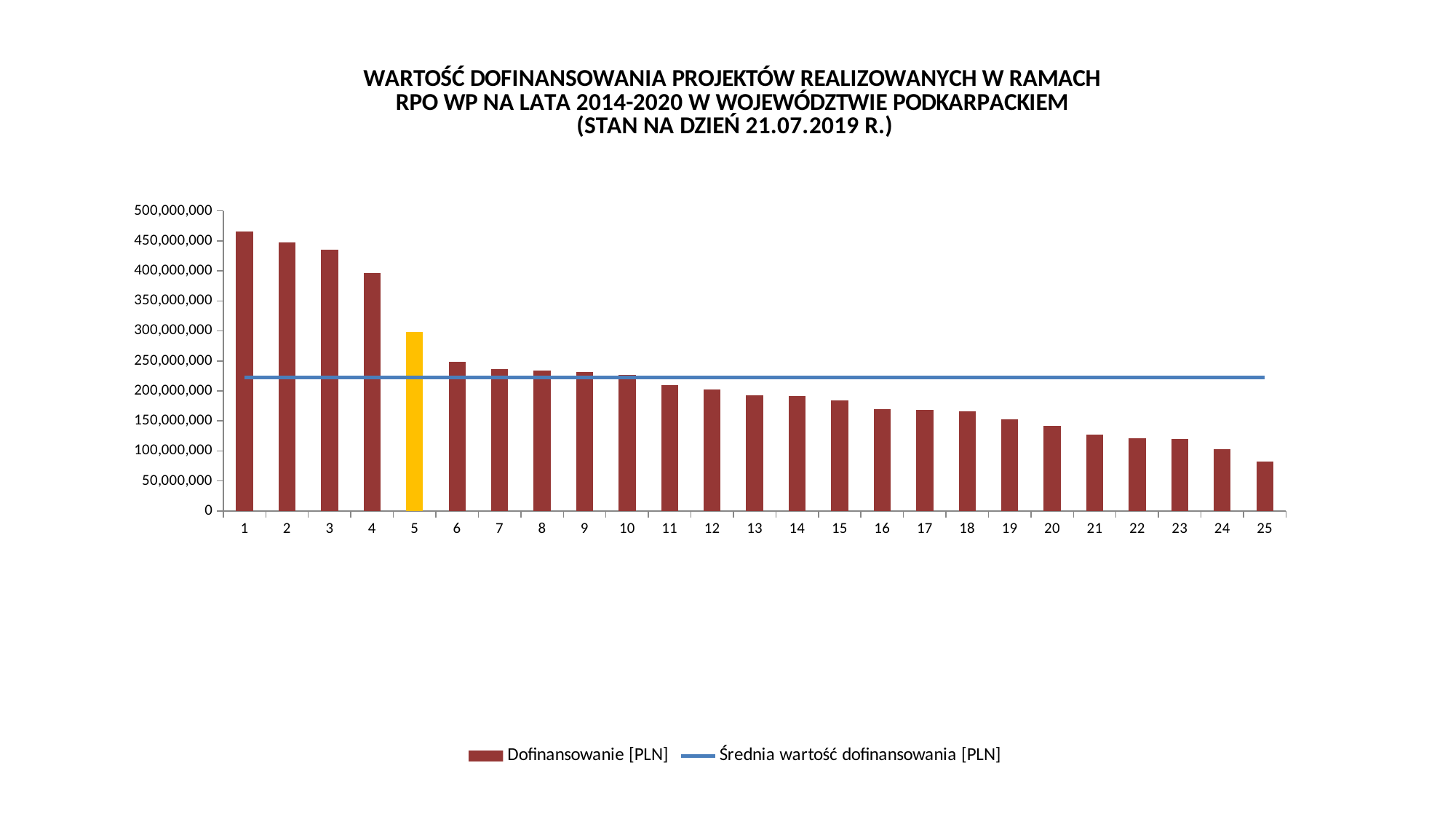
Do the bar values rise or fall from left to right along the x axis? fall Which bar has the lowest value? 25 Is the value for bar 5 greater or less than 250,000,000? greater Is the value for bar 20 greater or less than 150,000,000? less Which bar has the highest value? 1 How many series does the legend list? 2 How many bars (projects) are plotted on the chart? 25 What kind of chart is shown on the slide? combination bar and line chart Which is larger, the value for bar 1 or the value for bar 4? bar 1 Is the value for bar 25 greater or less than 100,000,000? less Which bar is highlighted in a different colour (yellow) from the others? 5